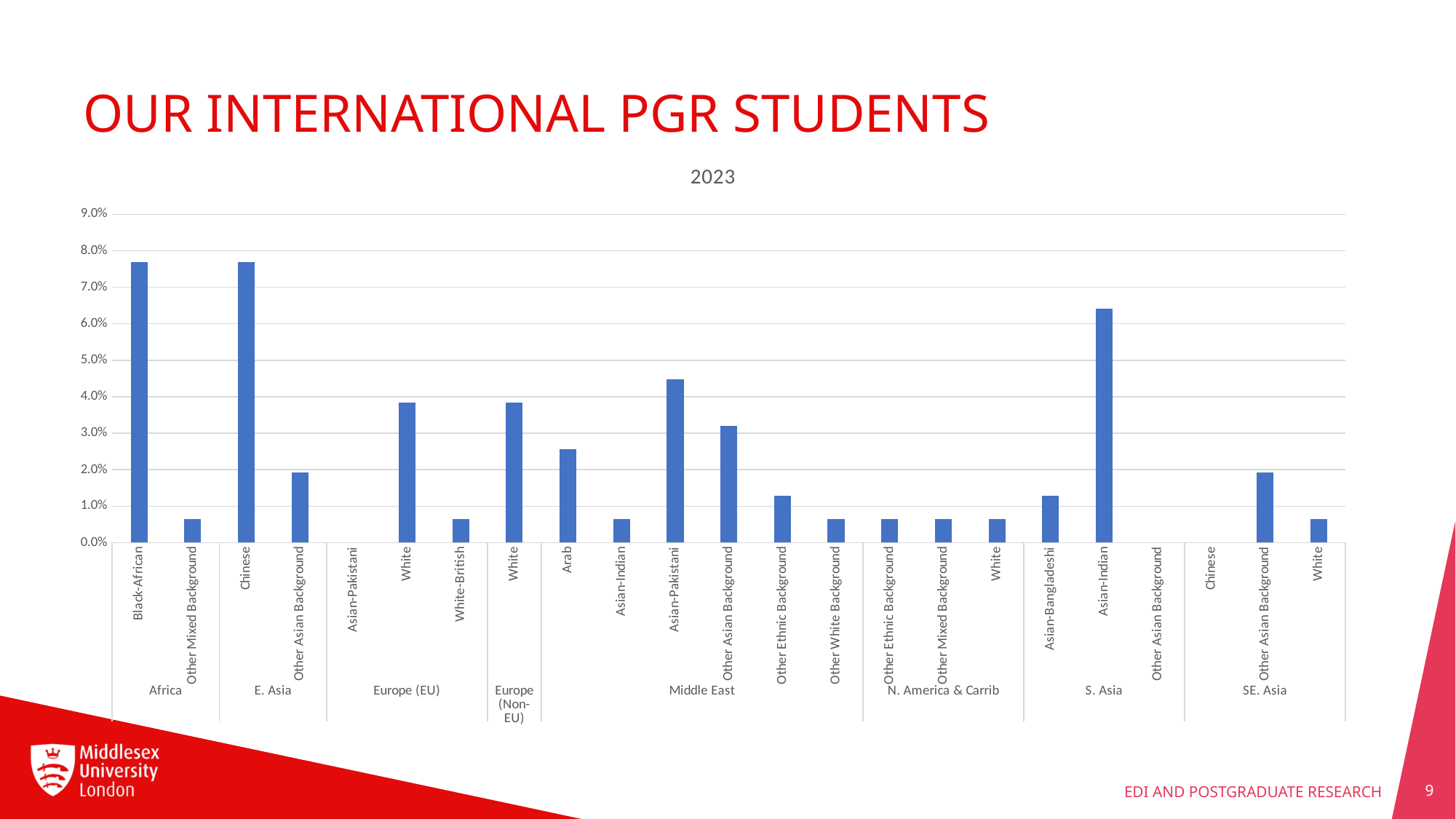
Which is larger: the value for Asian-Pakistani in the Middle East group or the value for Arab? Asian-Pakistani Is the value for Arab in the Middle East group greater or less than 2.0%? greater What is the highest value shown on the vertical axis of the chart? 9.0% What kind of chart is shown on the slide? bar chart Is the value for Asian-Indian in the S. Asia group greater or less than 6.0%? greater Is the value for White in the Europe (EU) group greater or less than 4.0%? less Which is larger: the value for Asian-Indian in the S. Asia group or the value for White in the Europe (EU) group? Asian-Indian How many regional groups are labelled along the x axis of the chart? 8 Which is larger: the value for Black-African in the Africa group or the value for Asian-Indian in the S. Asia group? Black-African What is the title of the chart? 2023